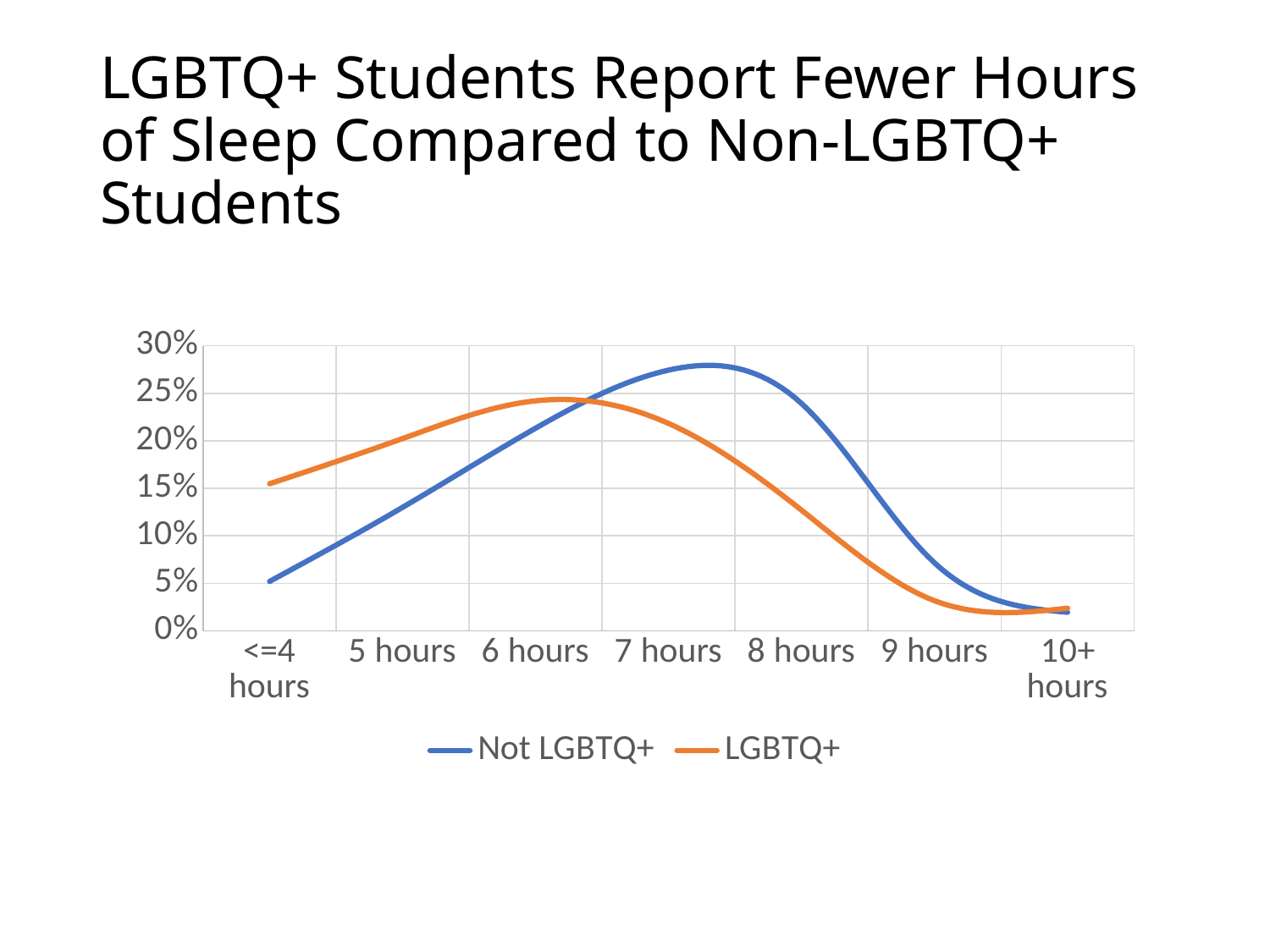
What kind of chart is shown on the slide? Line chart At <=4 hours, which series has the larger value, Not LGBTQ+ or LGBTQ+? LGBTQ+ Which colour represents the LGBTQ+ series in the legend? Orange Is the value for LGBTQ+ at <=4 hours greater or less than 10%? greater How many sleep-hour categories are shown on the x axis? 7 Does the Not LGBTQ+ line rise or fall from 8 hours to 10+ hours? Fall At 8 hours, which series has the larger value, Not LGBTQ+ or LGBTQ+? Not LGBTQ+ For the Not LGBTQ+ series, which sleep-hour category has the highest value? 7 hours For the LGBTQ+ series, which sleep-hour category has the highest value? 6 hours Is the value for Not LGBTQ+ at <=4 hours greater or less than 10%? less How many series does the legend list? 2